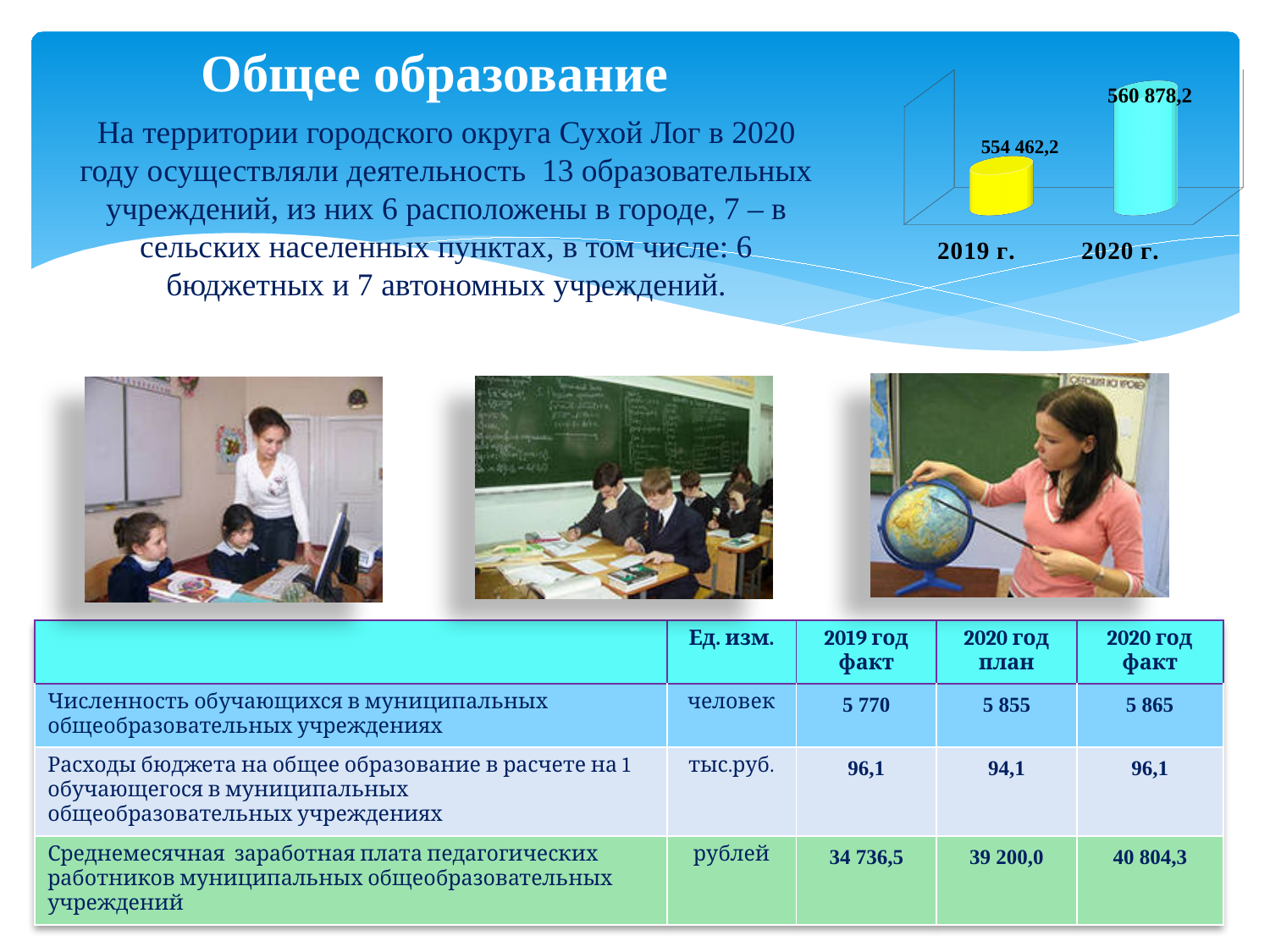
Is the value for 2019 г. larger or smaller than the value for 2020 г. in the chart? smaller What colour is the bar for 2020 г. in the chart? cyan By how much does the 2020 г. value exceed the 2019 г. value in the chart? 6 416,0 What is the value shown for 2020 г. in the chart? 560 878,2 Which year has the lower value in the chart? 2019 г. What kind of chart is shown in the top right of the slide? bar chart How many categories (years) are plotted in the chart? 2 What is the value shown for 2019 г. in the chart? 554 462,2 Which year has the higher value in the chart? 2020 г. Does the value rise or fall from 2019 г. to 2020 г. in the chart? rise What colour is the bar for 2019 г. in the chart? yellow